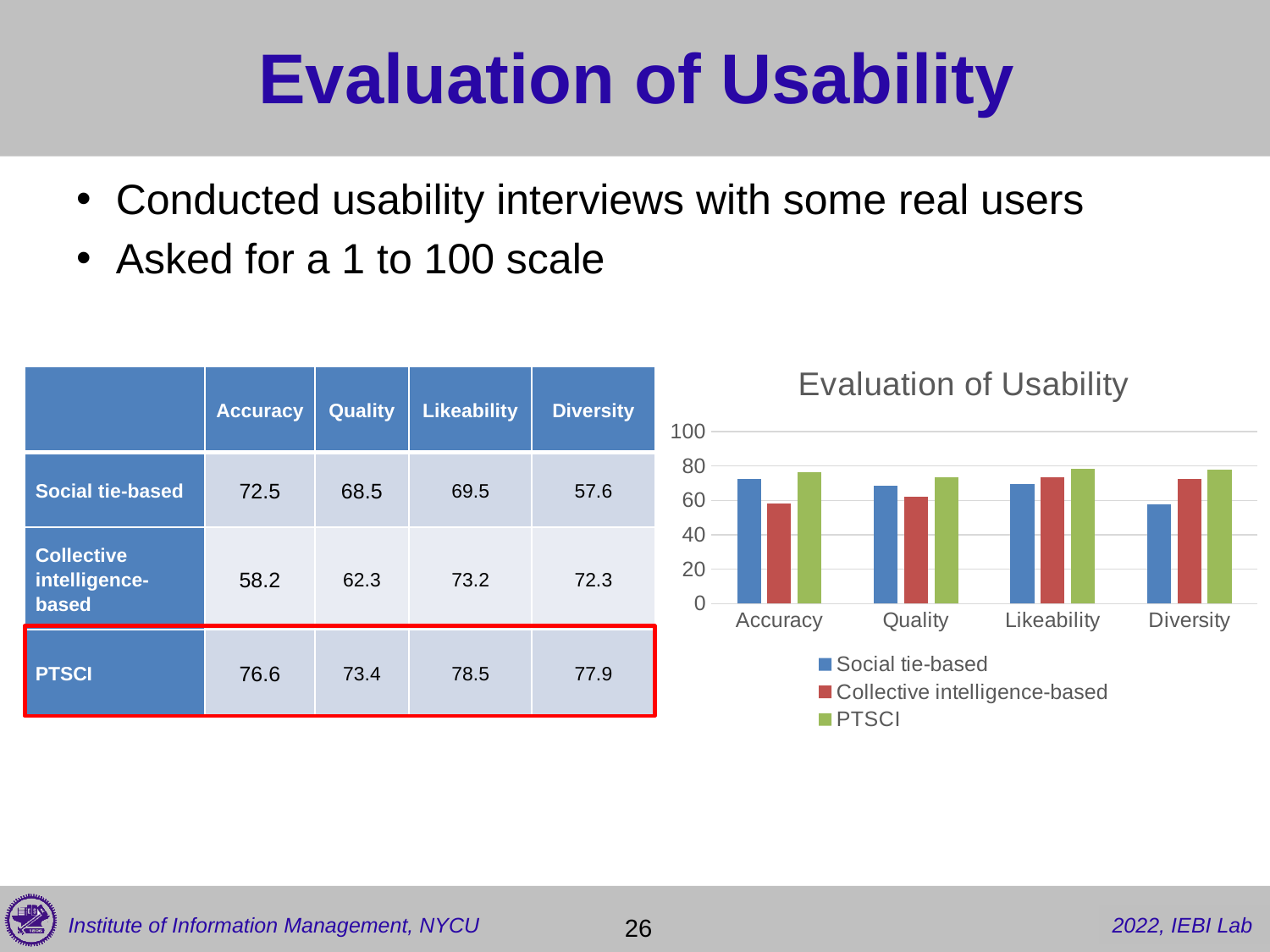
How many categories are shown on the x axis of the chart? 4 What is the difference between the PTSCI and Social tie-based values for Diversity? 20.3 What is the PTSCI value for Likeability? 78.5 What is the title of the chart? Evaluation of Usability Which series has the lowest value for Diversity? Social tie-based What is the Social tie-based value for Diversity? 57.6 How many series does the chart legend list? 3 Is the Collective intelligence-based value for Accuracy greater or less than 60? less What kind of chart is shown on the slide? bar chart Which series has the highest value for Accuracy? PTSCI Is the PTSCI value for Diversity greater or less than 60? greater Which is larger for Quality: the Social tie-based value or the Collective intelligence-based value? Social tie-based